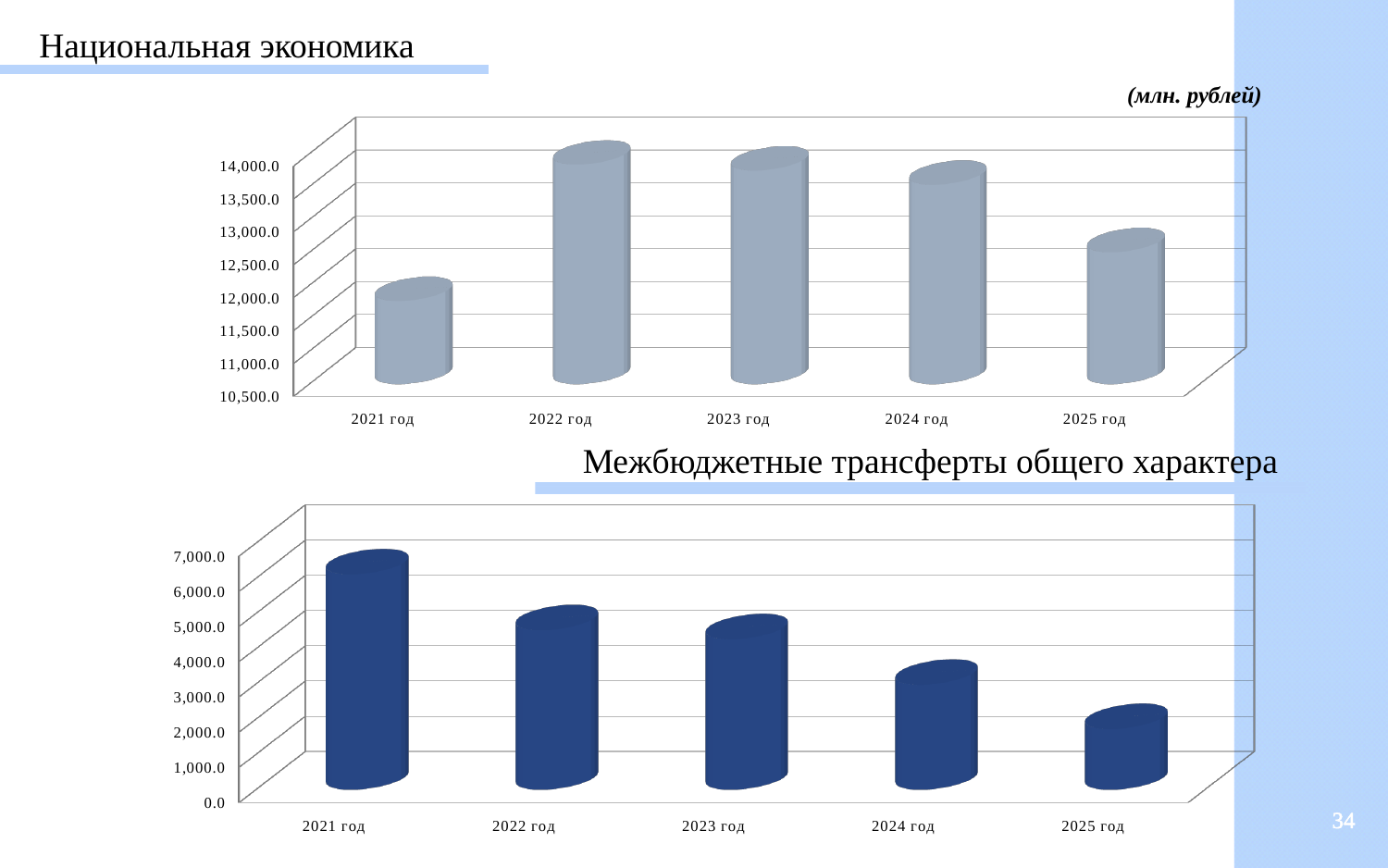
In the top chart "Национальная экономика", which is larger, the value for 2021 год or the value for 2025 год? 2025 год In the top chart "Национальная экономика", how many years are shown on the x axis? 5 In the top chart "Национальная экономика", is the value for 2024 год greater or less than 13,000.0? greater In the bottom chart "Межбюджетные трансферты общего характера", is the value for 2025 год greater or less than 3,000.0? less In the bottom chart "Межбюджетные трансферты общего характера", which year has the lowest value? 2025 год In the bottom chart "Межбюджетные трансферты общего характера", which year has the highest value? 2021 год In the bottom chart "Межбюджетные трансферты общего характера", do the values rise or fall from 2021 год to 2025 год? fall In the top chart "Национальная экономика", which year has the lowest value? 2021 год What unit of measurement is stated on the slide for the charts? млн. рублей In the top chart "Национальная экономика", is the value for 2025 год greater or less than 12,000.0? greater What kind of chart is the top chart titled "Национальная экономика"? bar chart In the top chart "Национальная экономика", which year has the highest value? 2022 год